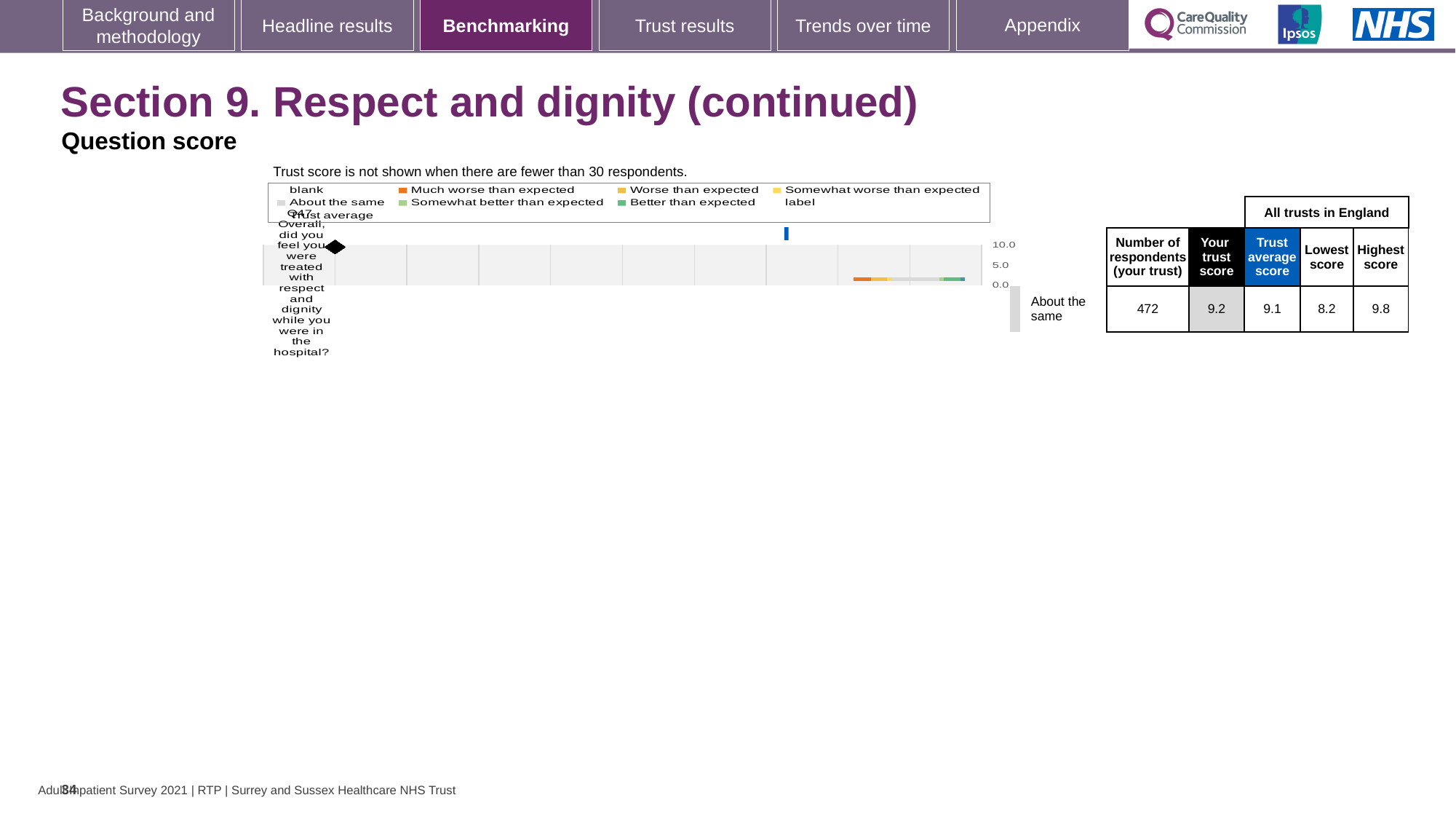
Which is larger for Q47: the trust's own score or the trust average score? the trust's own score What is the difference between the highest and lowest scores for Q47 across all trusts in England? 1.6 What benchmarking category is the trust's Q47 score assigned to? About the same How many questions (categories) are plotted in the chart? 1 What kind of chart is shown on the slide? bar chart How many respondents from the trust answered Q47? 472 What is the highest value shown on the chart's numeric axis? 10.0 What is the lowest score among all trusts in England for Q47? 8.2 What is the trust score for Q47 (Overall, did you feel you were treated with respect and dignity while you were in the hospital?)? 9.2 What is the highest score among all trusts in England for Q47? 9.8 What is the trust average score for Q47? 9.1 Is the trust score for Q47 greater or less than 5.0? greater